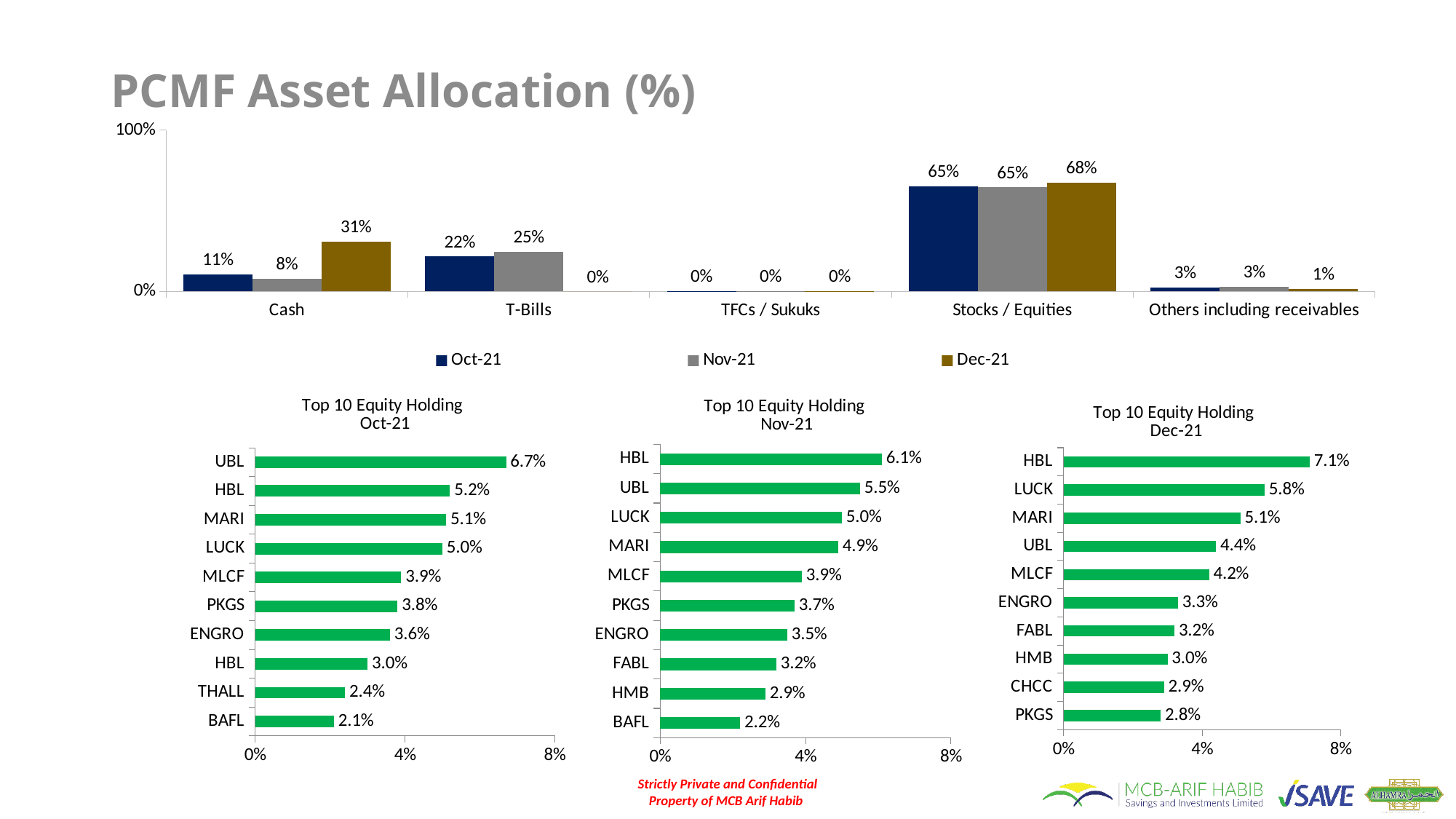
In the PCMF Asset Allocation chart, what is the Nov-21 value for T-Bills? 25% In the Top 10 Equity Holding Oct-21 chart, which holding has the lowest value? BAFL In the PCMF Asset Allocation chart, how many categories are shown on the x axis? 5 In the Top 10 Equity Holding Dec-21 chart, what is the difference between the values for HBL and LUCK? 1.3% In the PCMF Asset Allocation chart, how many series does the legend list? 3 In the PCMF Asset Allocation chart, which category has the highest Dec-21 value? Stocks / Equities In the Top 10 Equity Holding Oct-21 chart, what is the value for UBL? 6.7% In the PCMF Asset Allocation chart, what is the difference between the Dec-21 and Oct-21 values for Stocks / Equities? 3% In the Top 10 Equity Holding Nov-21 chart, which is larger, the value for HBL or the value for UBL? HBL In the Top 10 Equity Holding Nov-21 chart, what is the value for LUCK? 5.0% What kind of chart is the Top 10 Equity Holding Dec-21 chart? Bar chart In the PCMF Asset Allocation chart, what is the Dec-21 value for Cash? 31%